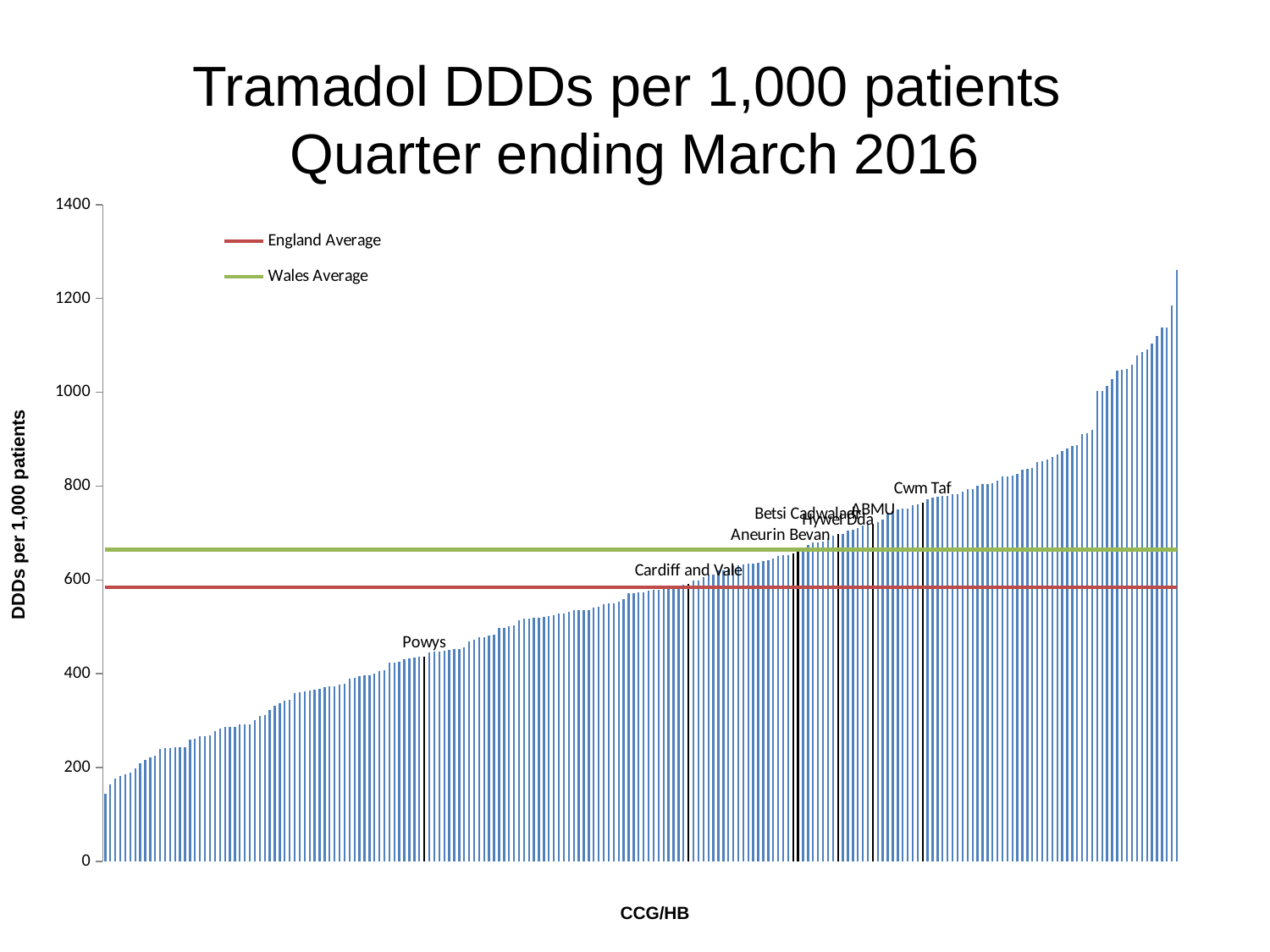
Which is larger, the value for Powys or the value for Cwm Taf? Cwm Taf Is the value for Powys greater or less than 600? less Of the labelled Welsh health boards, which has the highest value? Cwm Taf How many entries does the legend list? 2 Do the bar values rise or fall from left to right along the x axis? rise Of the labelled Welsh health boards, which has the lowest value? Powys Is the Wales Average line greater or less than 800? less What kind of chart is shown on the slide? bar chart What is the label on the y axis of the chart? DDDs per 1,000 patients Which is higher, the England Average line or the Wales Average line? Wales Average Is the value for Cwm Taf greater or less than 600? greater